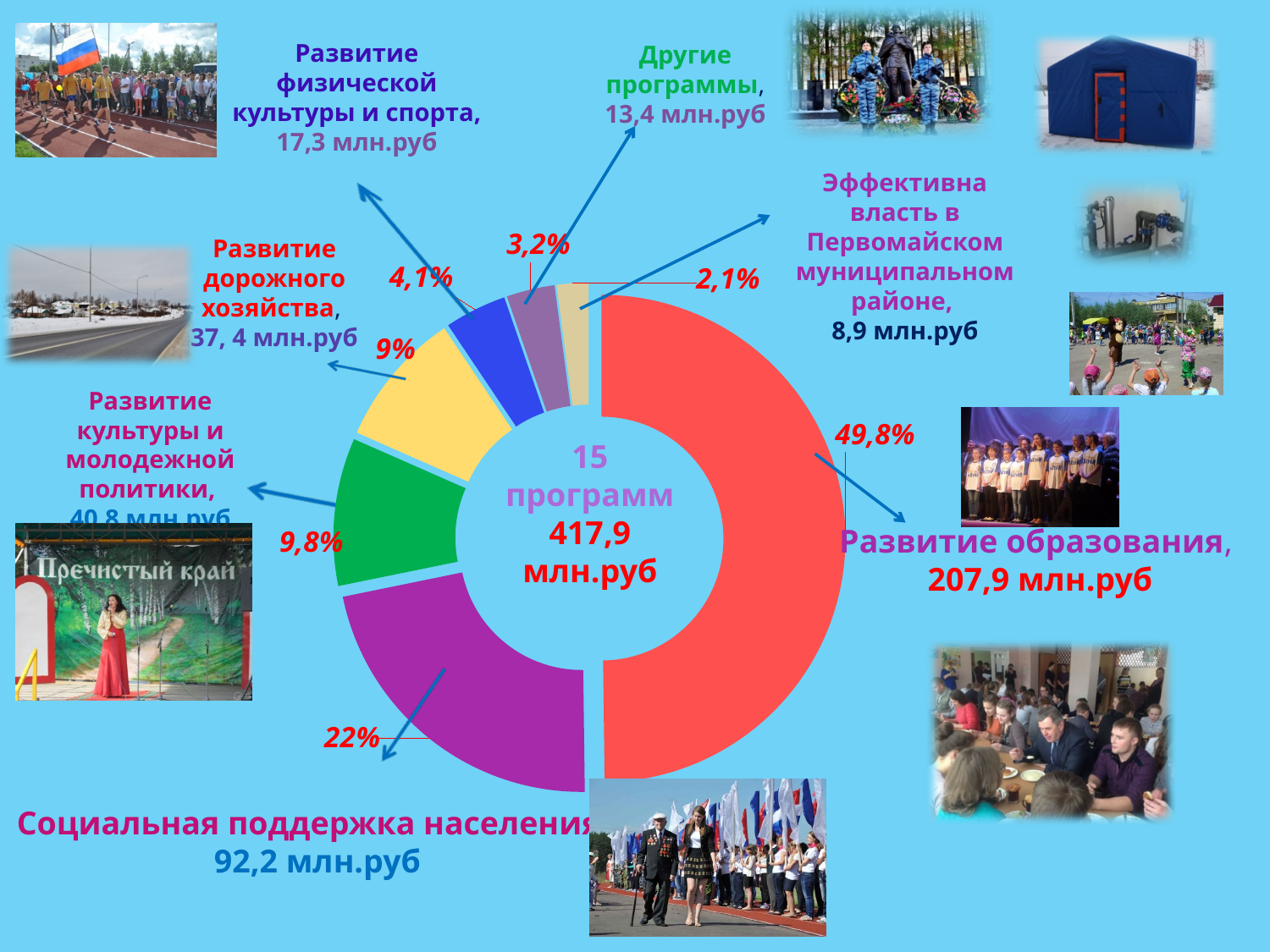
What percentage share does the slice for Развитие образования have? 49,8% What kind of chart is shown on the slide? Donut (pie) chart What percentage share does the slice for Социальная поддержка населения have? 22% What is the amount shown for Развитие дорожного хозяйства? 37, 4 млн.руб How many slices does the donut chart have? 7 What total amount is shown in the centre of the donut chart? 417,9 млн.руб Which category has the smallest slice of the chart? Эффективна власть в Первомайском муниципальном районе Which category has the largest slice of the chart? Развитие образования How many programmes does the centre of the chart say are included? 15 программ What is the amount shown for Развитие физической культуры и спорта? 17,3 млн.руб What is the difference in percentage points between the Развитие образования slice and the Социальная поддержка населения slice? 27,8 Which slice is larger: Развитие культуры и молодежной политики or Развитие дорожного хозяйства? Развитие культуры и молодежной политики